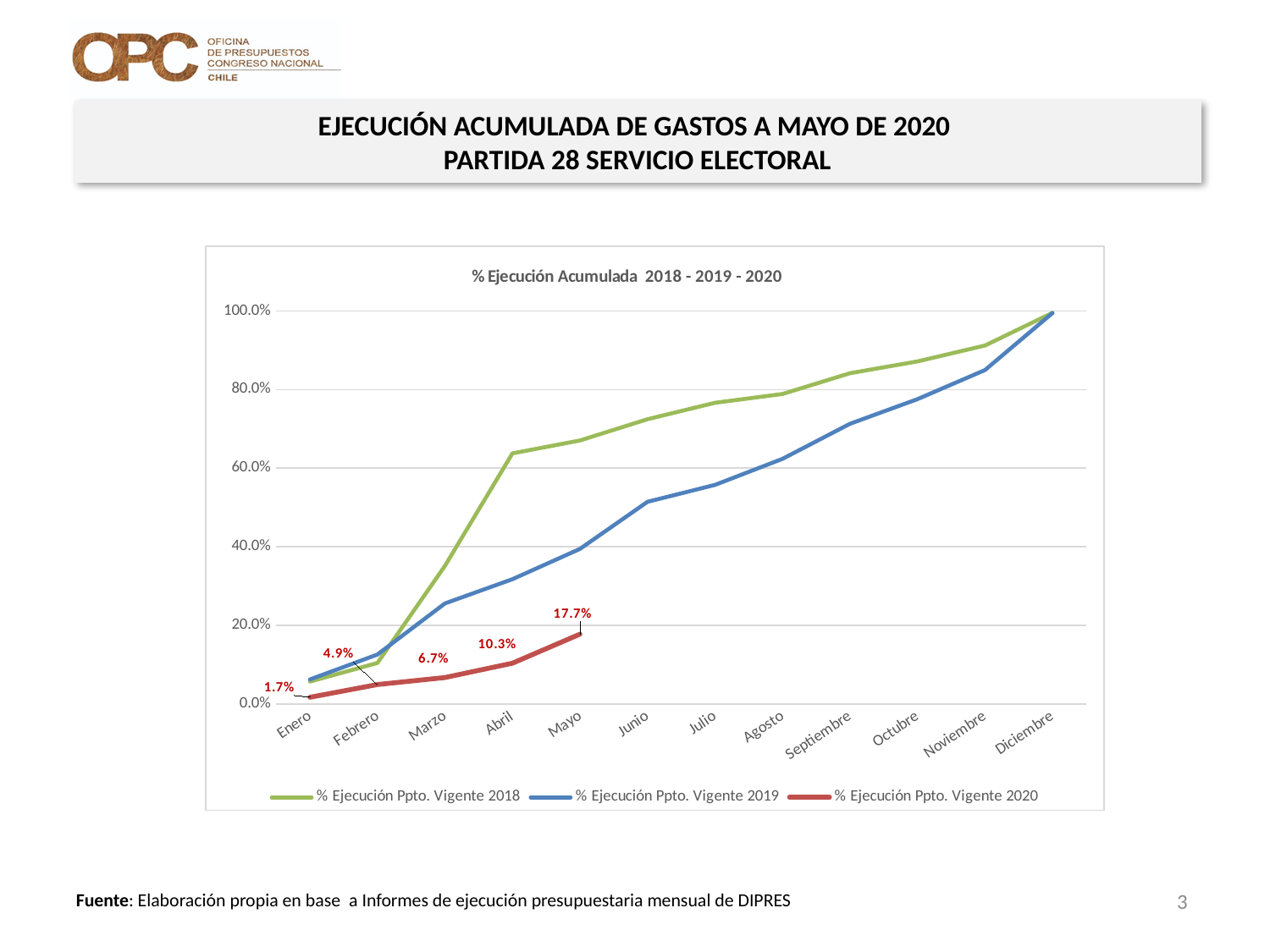
What is the value of % Ejecución Ppto. Vigente 2020 in Marzo? 6.7% What is the title of the chart? % Ejecución Acumulada 2018 - 2019 - 2020 How many months are shown along the x axis? 12 What is the value of % Ejecución Ppto. Vigente 2020 in Mayo? 17.7% Is the value of % Ejecución Ppto. Vigente 2018 in Abril greater or less than 60.0%? greater How many series does the legend list? 3 Does the % Ejecución Ppto. Vigente 2020 line rise or fall from Enero to Mayo? rise What is the value of % Ejecución Ppto. Vigente 2020 in Enero? 1.7% What is the value of % Ejecución Ppto. Vigente 2020 in Abril? 10.3% Which series has the highest value in Abril? % Ejecución Ppto. Vigente 2018 What kind of chart is shown on the slide? Line chart By how many percentage points did % Ejecución Ppto. Vigente 2020 increase from Abril to Mayo? 7.4